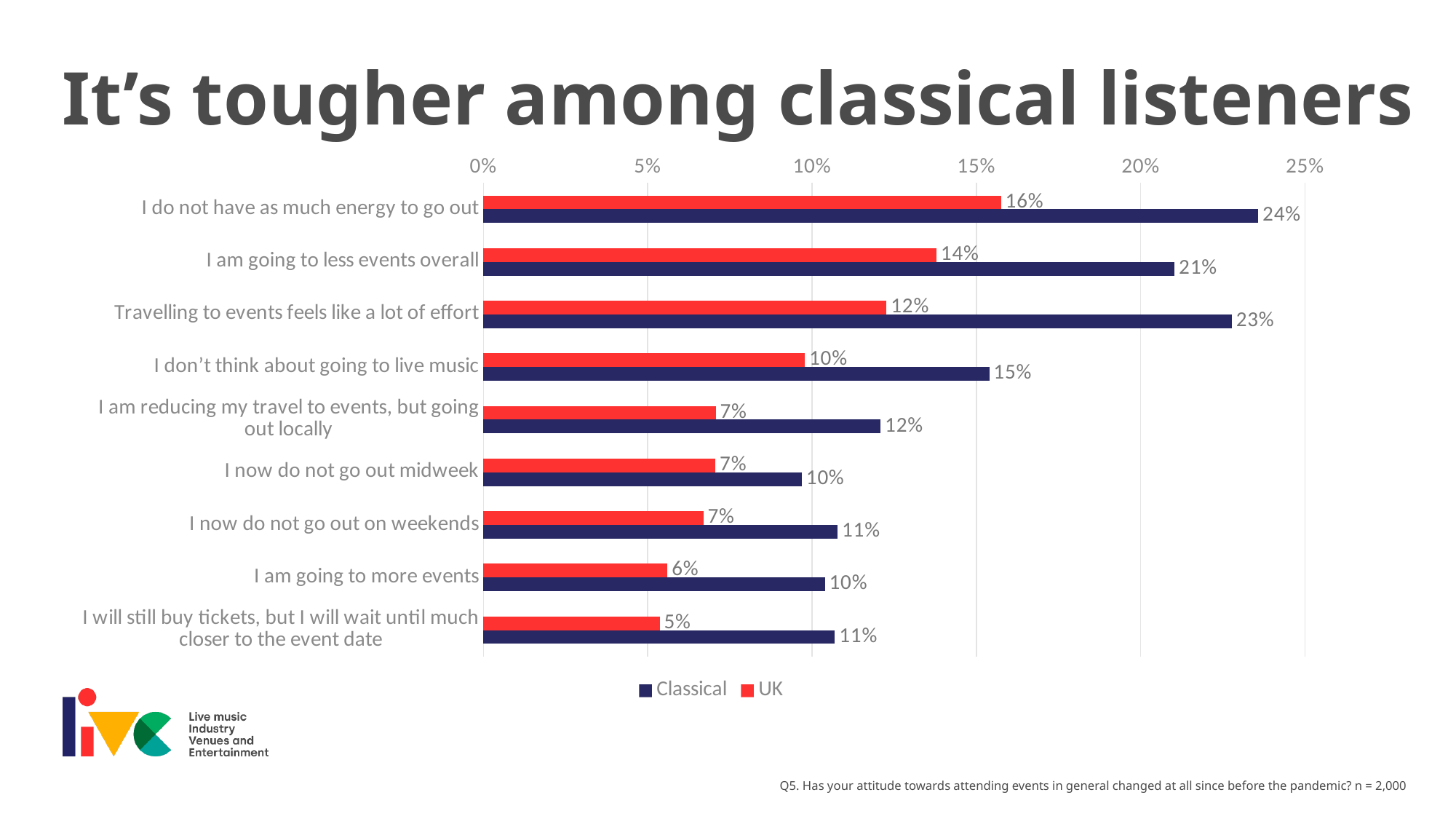
Which category has the highest Classical value? I do not have as much energy to go out What is the Classical value for "I am going to less events overall"? 21% Which category has the lowest UK value? I will still buy tickets, but I will wait until much closer to the event date Is the Classical value for "I am going to less events overall" greater or less than 20%? greater What is the difference between the Classical and UK values for "Travelling to events feels like a lot of effort"? 11% What is the Classical value for "I do not have as much energy to go out"? 24% What kind of chart is shown on the slide? Bar chart Which colour represents the UK series in the legend? Red How many series does the legend list? 2 What is the UK value for "Travelling to events feels like a lot of effort"? 12% How many categories are shown on the chart? 9 Which is larger for "I don't think about going to live music": the Classical value or the UK value? Classical